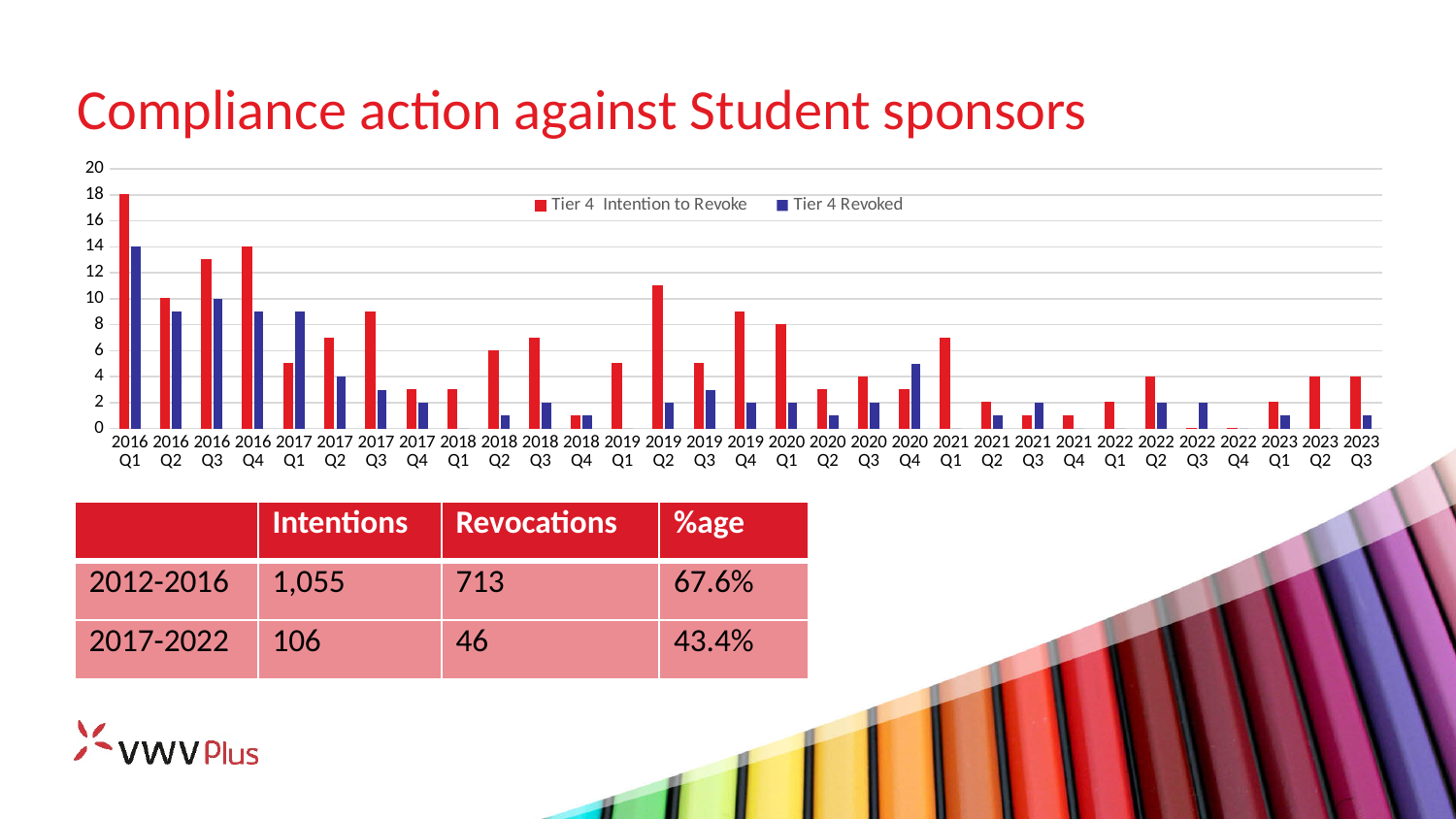
Overall, do the Tier 4 Intention to Revoke values rise or fall from 2016 to 2023? fall Which colour represents the Tier 4 Revoked series in the chart? blue In which quarter is the Tier 4 Intention to Revoke value highest? 2016 Q1 What is the Tier 4 Intention to Revoke value for 2020 Q1? 8 How many series does the chart legend list? 2 What is the Tier 4 Revoked value for 2016 Q1? 14 In 2020 Q4, which is larger: Tier 4 Intention to Revoke or Tier 4 Revoked? Tier 4 Revoked Is the Tier 4 Intention to Revoke value for 2019 Q2 greater or less than 8? greater What kind of chart is shown on the slide? bar chart What is the Tier 4 Intention to Revoke value for 2016 Q1? 18 What is the difference between Tier 4 Intention to Revoke and Tier 4 Revoked in 2016 Q1? 4 What is the title of the slide containing the chart? Compliance action against Student sponsors